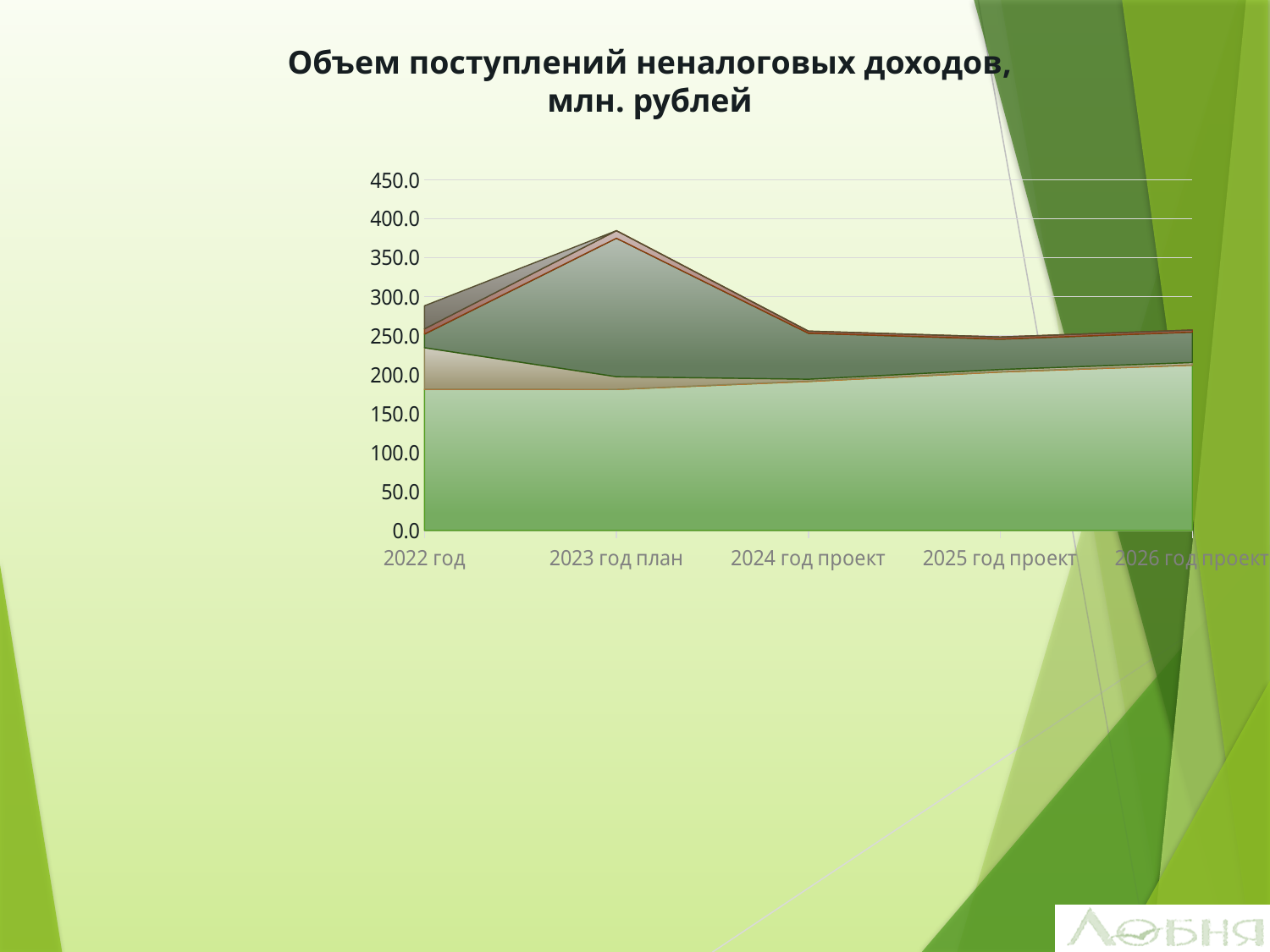
Is the value of the lower series for 2022 год greater or less than 200? less How many categories are shown on the x axis of the chart? 5 What is the title of the chart? Объем поступлений неналоговых доходов, млн. рублей What kind of chart is shown on the slide? area chart How many data series are plotted in the chart? 6 Does the lower series rise or fall from 2023 год план to 2026 год проект? rise Is the value of the lower series for 2026 год проект greater or less than 250? less